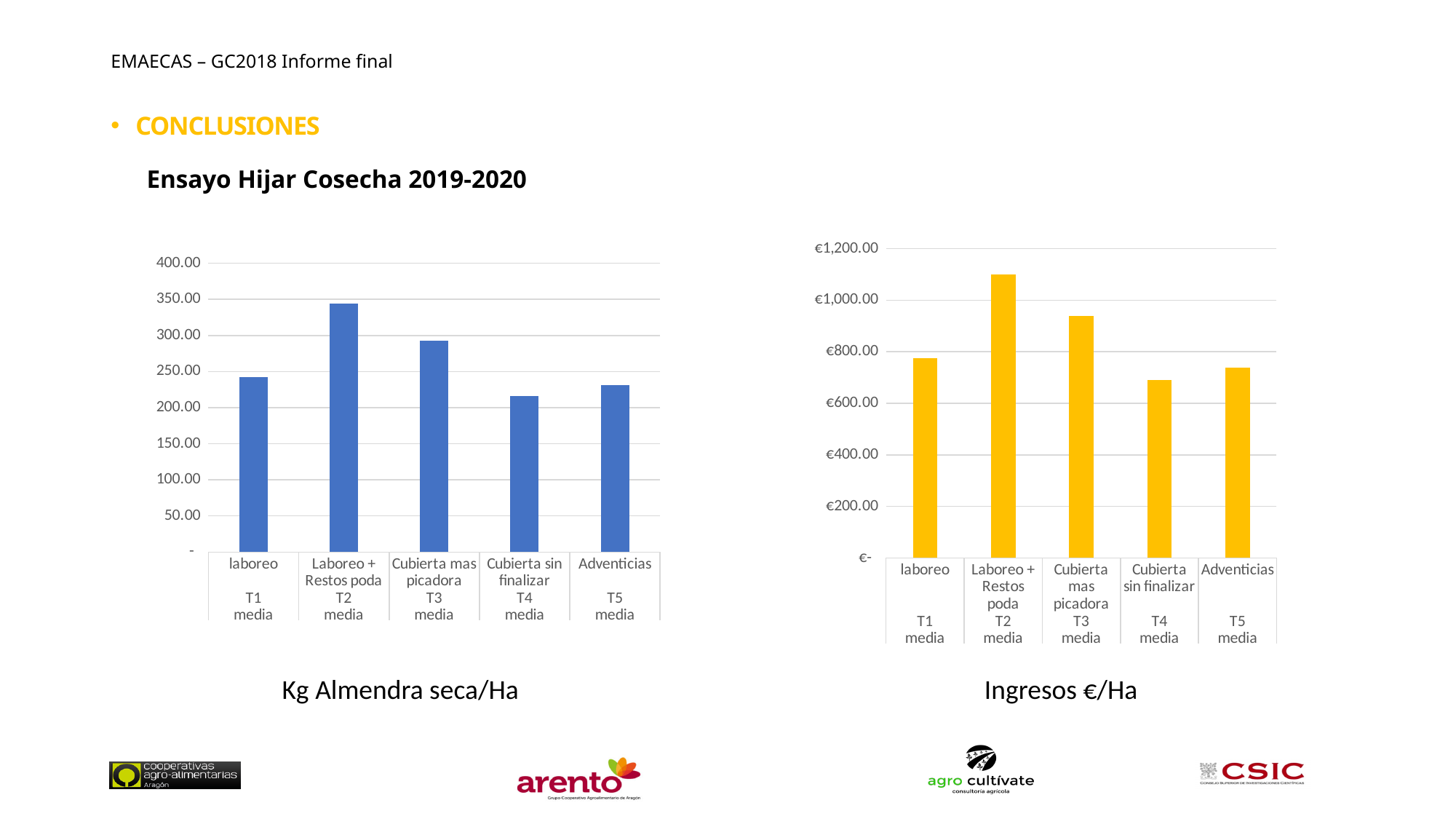
In the Kg Almendra seca/Ha chart on the left, which is larger: the value for Cubierta mas picadora (T3) or the value for laboreo (T1)? Cubierta mas picadora (T3) How many categories are shown in the Kg Almendra seca/Ha chart on the left? 5 In the Ingresos €/Ha chart on the right, which category has the lowest bar? Cubierta sin finalizar (T4 media) In the Ingresos €/Ha chart on the right, is the value for Laboreo + Restos poda (T2) greater or less than €1,000.00? greater In the Kg Almendra seca/Ha chart on the left, is the value for Laboreo + Restos poda (T2) greater or less than 300.00? greater In the Ingresos €/Ha chart on the right, which is larger: the value for laboreo (T1) or the value for Adventicias (T5)? laboreo (T1) What kind of chart is the Ingresos €/Ha chart on the right? bar chart In the Kg Almendra seca/Ha chart on the left, which category has the highest bar? Laboreo + Restos poda (T2 media) In the Ingresos €/Ha chart on the right, is the value for Cubierta sin finalizar (T4) greater or less than €800.00? less In the Kg Almendra seca/Ha chart on the left, which category has the lowest bar? Cubierta sin finalizar (T4 media) In the Ingresos €/Ha chart on the right, which category has the highest bar? Laboreo + Restos poda (T2 media)